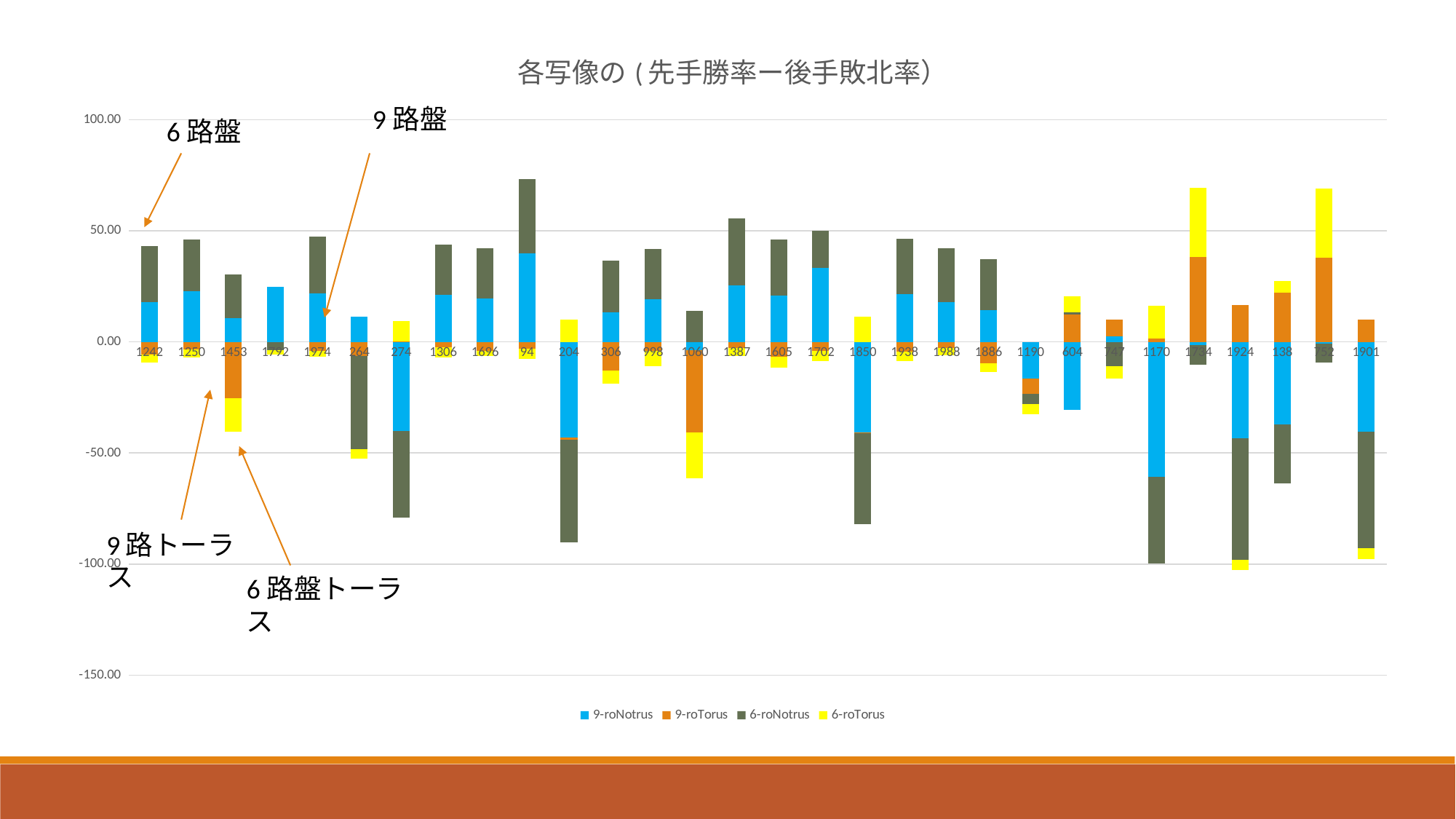
How many series does the legend list? 4 Is the 9-roNotrus value for category 1792 greater or less than 50? less Is the 9-roNotrus value for category 94 greater or less than 50? less How many categories are plotted along the x axis? 30 Is the 9-roNotrus value for category 1924 greater or less than -50? greater Which series is shown in yellow in the legend? 6-roTorus What kind of chart is shown on the slide? Stacked bar chart What is the title of the chart? 各写像の(先手勝率ー後手敗北率）